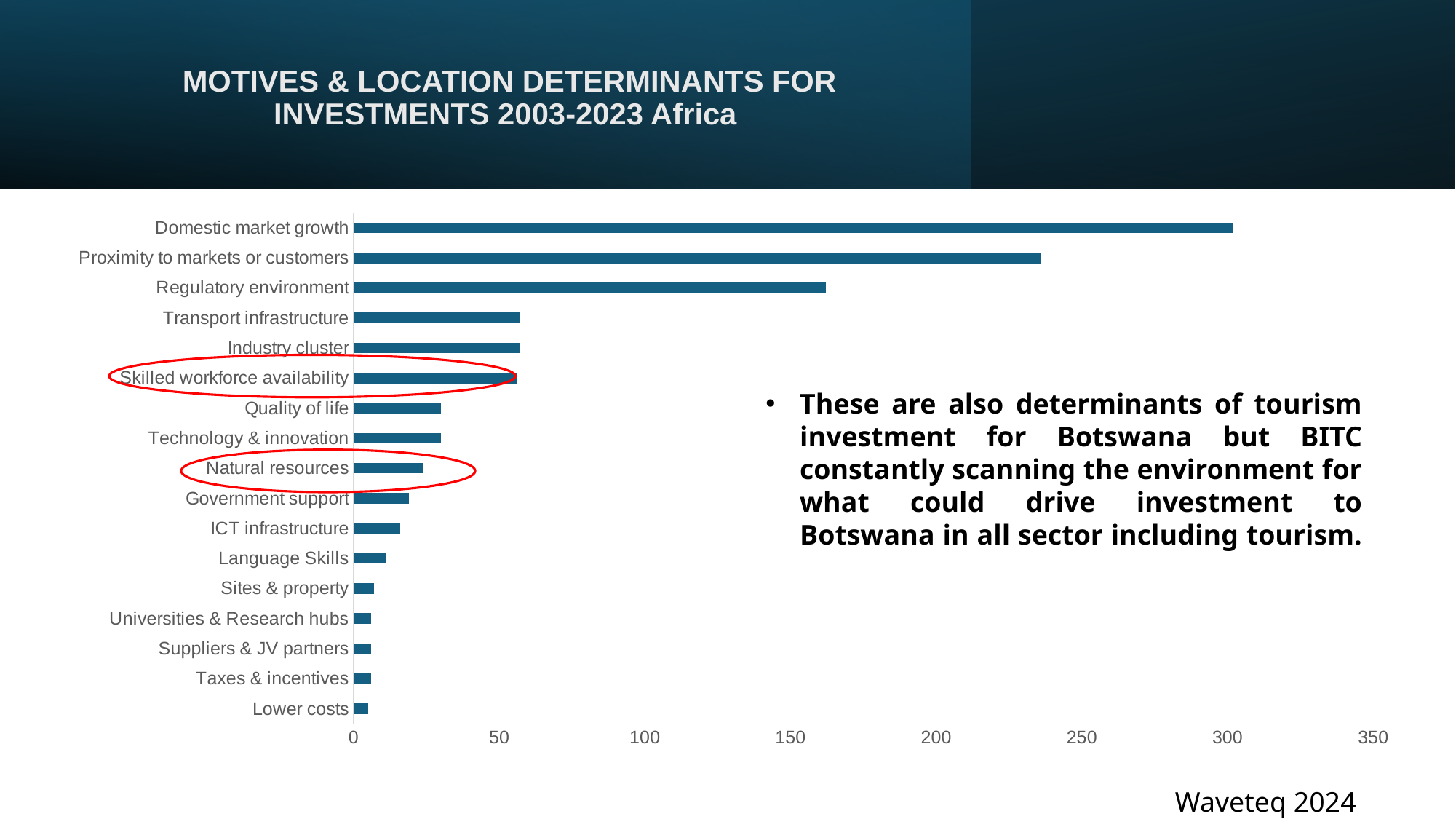
How many categories are plotted in the chart? 17 Is the value for Proximity to markets or customers greater or less than 200? greater What kind of chart is shown on the slide? Bar chart Which category has the highest value in the chart? Domestic market growth Which two categories are circled in red on the chart? Skilled workforce availability and Natural resources Which is larger, the value for Domestic market growth or the value for Proximity to markets or customers? Domestic market growth Is the value for Domestic market growth greater or less than 250? greater Do the bar values rise or fall going from the top category to the bottom category? fall Which is larger, the value for Regulatory environment or the value for Transport infrastructure? Regulatory environment Is the value for Natural resources greater or less than 50? less